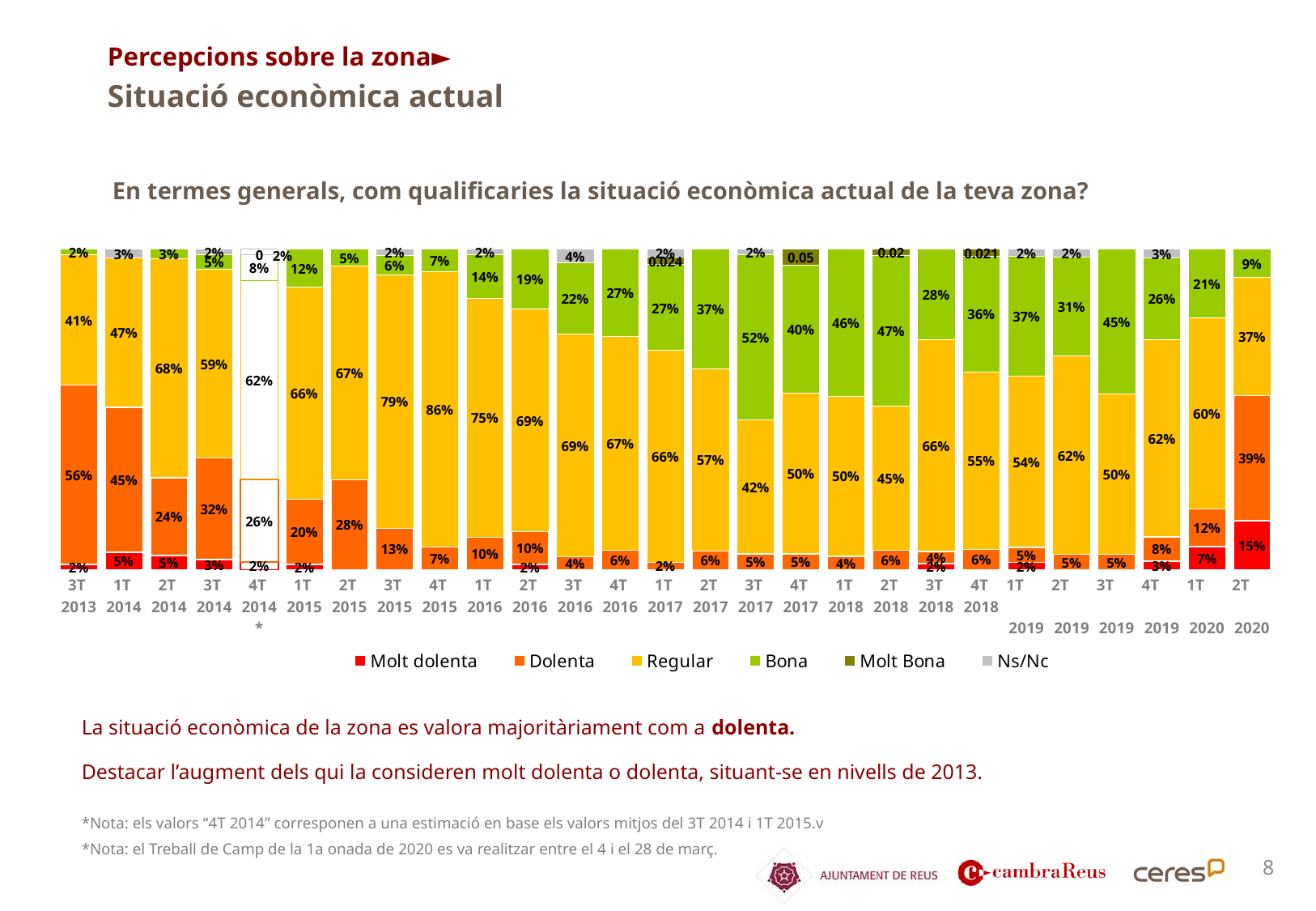
Which is larger: the Bona share in 3T 2017 or in 2T 2018? 3T 2017 Does the Bona share rise or fall from 4T 2019 to 2T 2020? Fall What is the value for Dolenta in 2T 2020? 39% How many series does the legend list? 6 What is the value for Molt dolenta in 1T 2020? 7% In which period is the Regular share highest? 4T 2015 What is the value for Regular in 4T 2015? 86% By how many percentage points does Dolenta in 2T 2020 exceed Dolenta in 1T 2020? 27 percentage points In which period is the Bona share highest? 3T 2017 What is the value for Bona in 3T 2019? 45% In which period is the Molt dolenta share highest? 2T 2020 What kind of chart is shown on the slide? Stacked bar chart